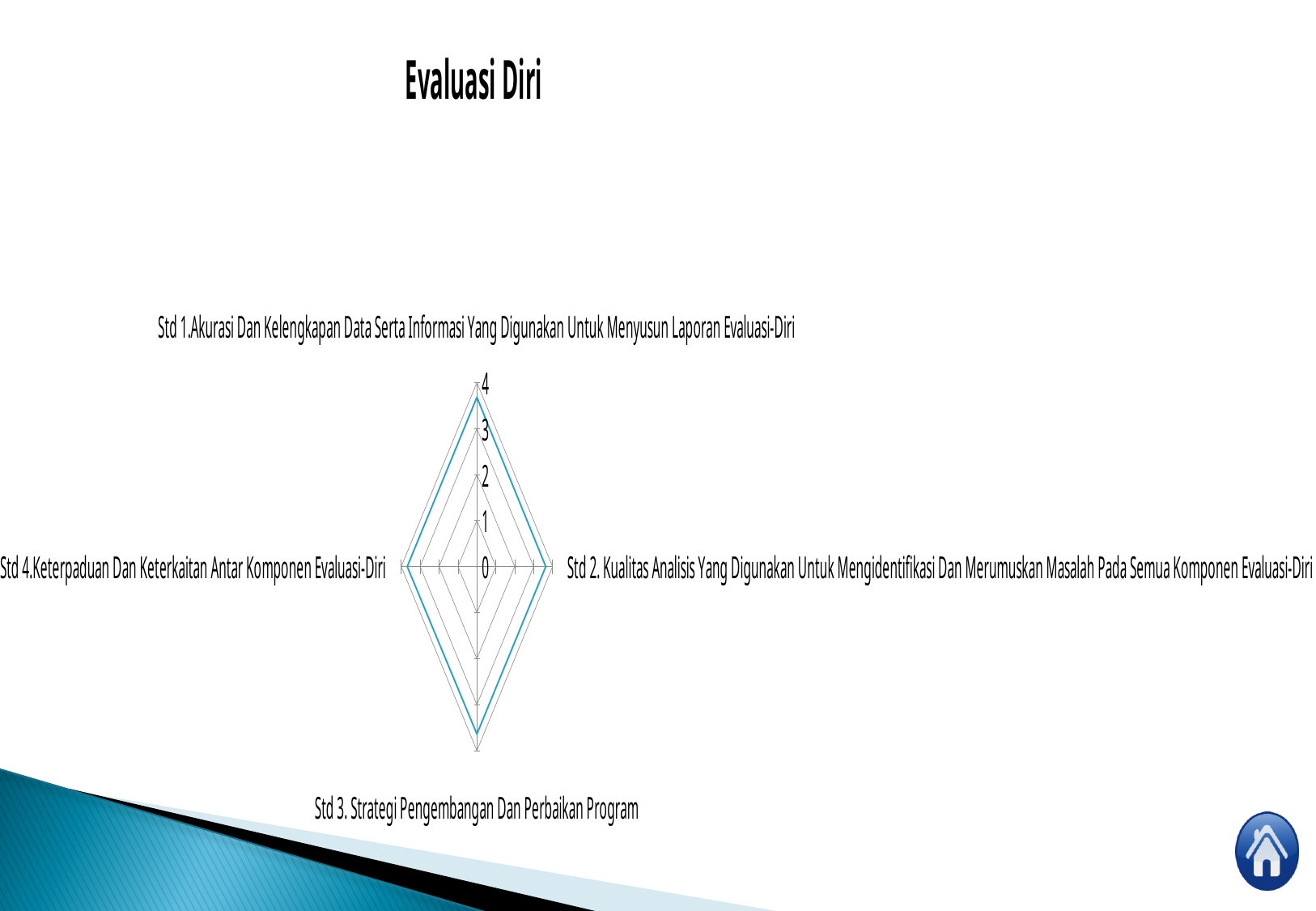
Is the value for Std 3 greater or less than 2? greater What is the maximum value shown on the chart's axis scale? 4 Is the value for Std 1 greater or less than 3? greater What is the title of the slide containing the chart? Evaluasi Diri How many categories (axes) does the radar chart have? 4 What kind of chart is shown on the slide? radar chart